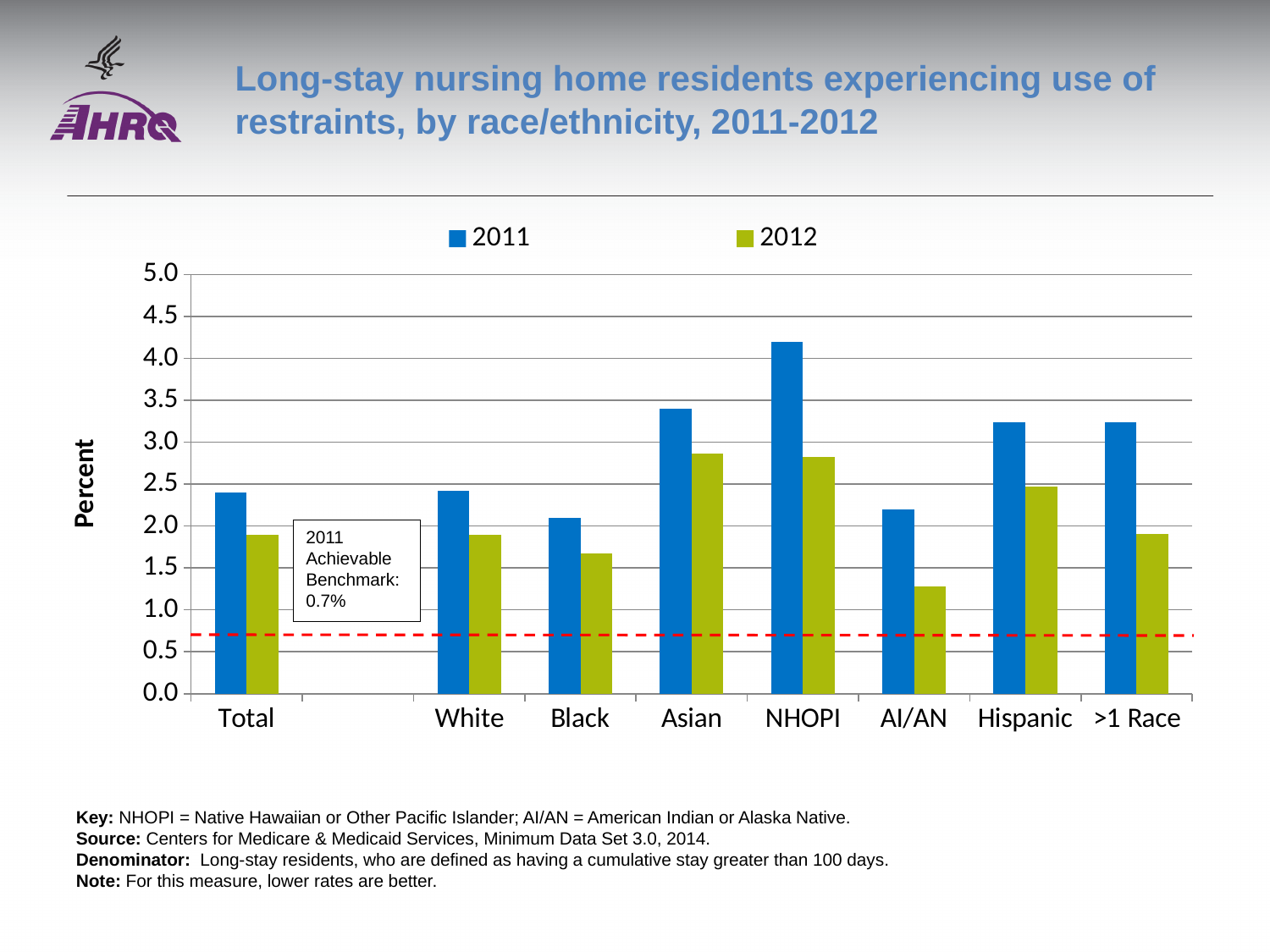
For the Hispanic category, which year has the larger value, 2011 or 2012? 2011 Is the 2012 value for AI/AN greater or less than 1.5? less Which category has the lowest value for 2012? AI/AN How many race/ethnicity categories are shown on the x axis? 8 Which category has the highest value for 2011? NHOPI What kind of chart is shown on the slide? Bar chart Which is larger, the 2011 value for Asian or the 2011 value for Black? Asian What is the 2011 achievable benchmark shown on the chart? 0.7% Is the 2011 value for NHOPI greater or less than 4.0? greater How many series does the legend list? 2 Is the 2011 value for Asian greater or less than 3.0? greater